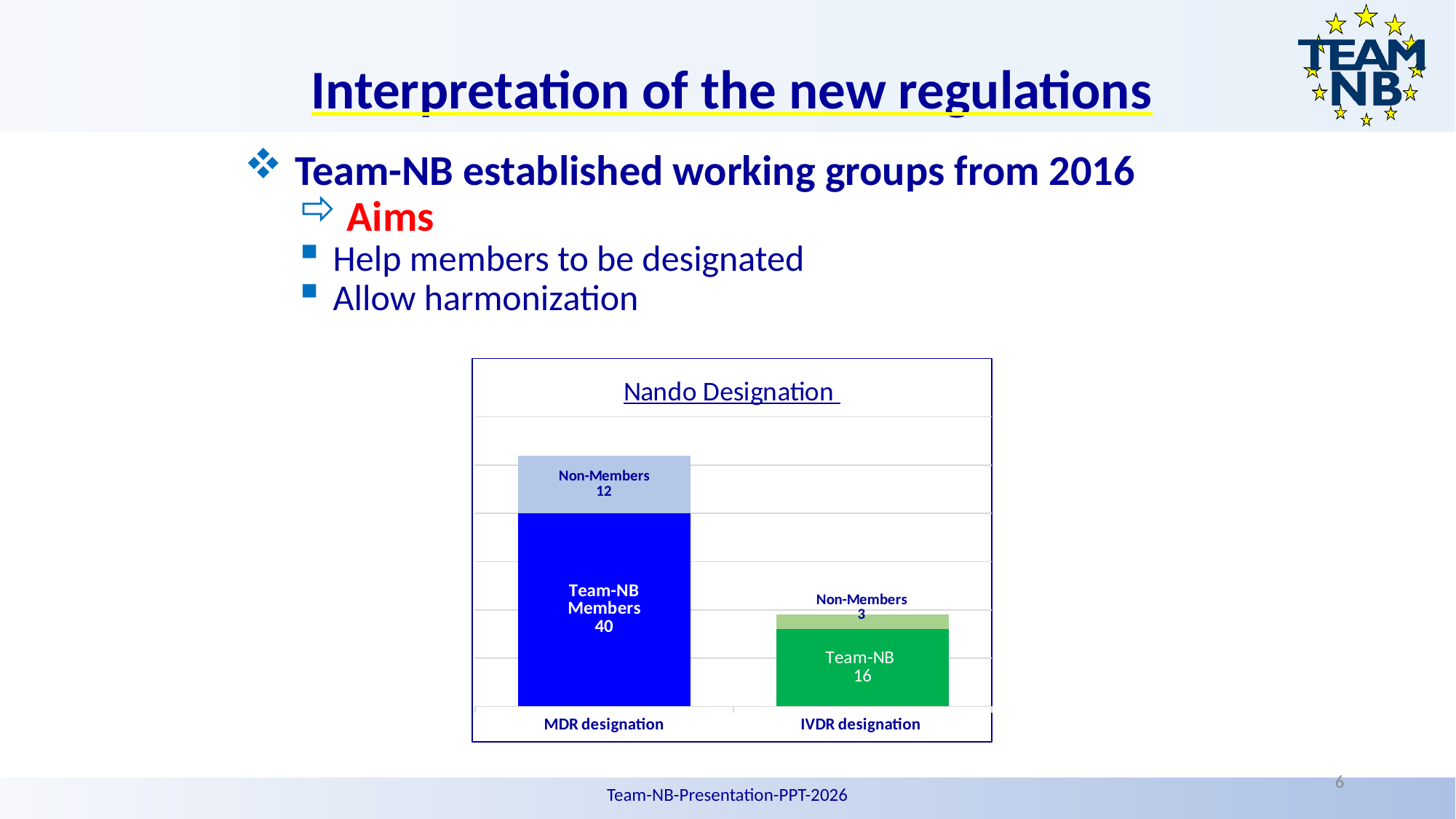
In the Nando Designation chart, how many Team-NB are shown for IVDR designation? 16 What kind of chart is shown on the slide? Stacked bar chart In the Nando Designation chart, what is the difference between Non-Members for MDR designation and Non-Members for IVDR designation? 9 How many categories are shown on the x axis of the Nando Designation chart? 2 In the Nando Designation chart, what is the difference between Team-NB Members for MDR designation and Team-NB for IVDR designation? 24 In the Nando Designation chart, how many Team-NB Members are shown for MDR designation? 40 What is the total of the IVDR designation stacked bar in the Nando Designation chart? 19 In the Nando Designation chart, how many Non-Members are shown for MDR designation? 12 In the Nando Designation chart, which category has the taller stacked bar, MDR designation or IVDR designation? MDR designation What is the title of the chart on the slide? Nando Designation In the Nando Designation chart, how many Non-Members are shown for IVDR designation? 3 What is the total of the MDR designation stacked bar in the Nando Designation chart? 52